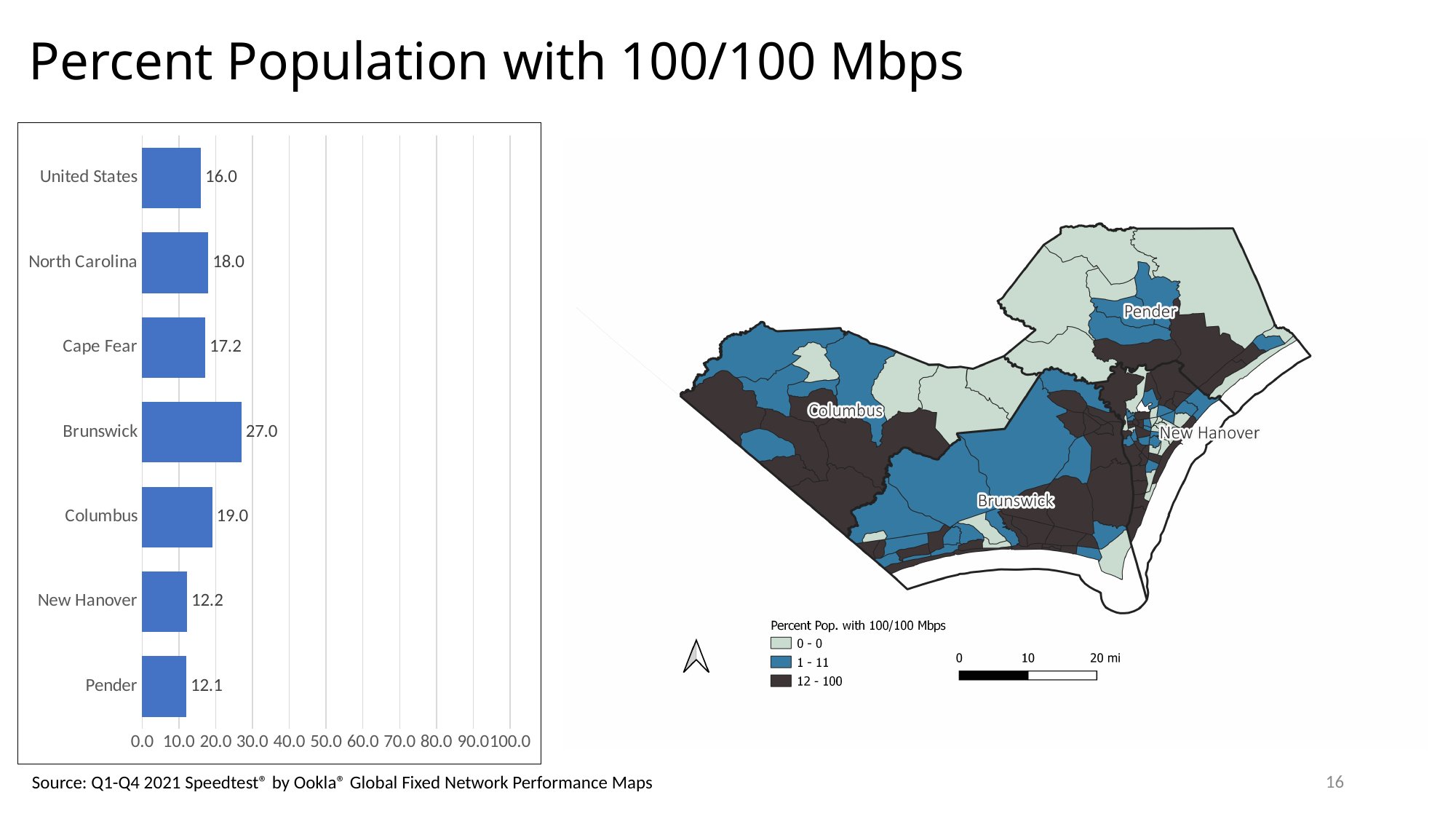
Which has a larger value in the bar chart, North Carolina or the United States? North Carolina How many categories are shown in the bar chart? 7 What kind of chart is shown on the left of the slide? Bar chart What is the difference between the values for Brunswick and Columbus in the bar chart? 8.0 Which category has the highest value in the bar chart? Brunswick What is the value for Cape Fear in the bar chart? 17.2 What is the value for Brunswick in the bar chart? 27.0 Is the value for Brunswick in the bar chart greater or less than 20.0? greater What is the title of the slide? Percent Population with 100/100 Mbps What is the value for New Hanover in the bar chart? 12.2 What is the value for the United States in the bar chart? 16.0 Which category has the lowest value in the bar chart? Pender